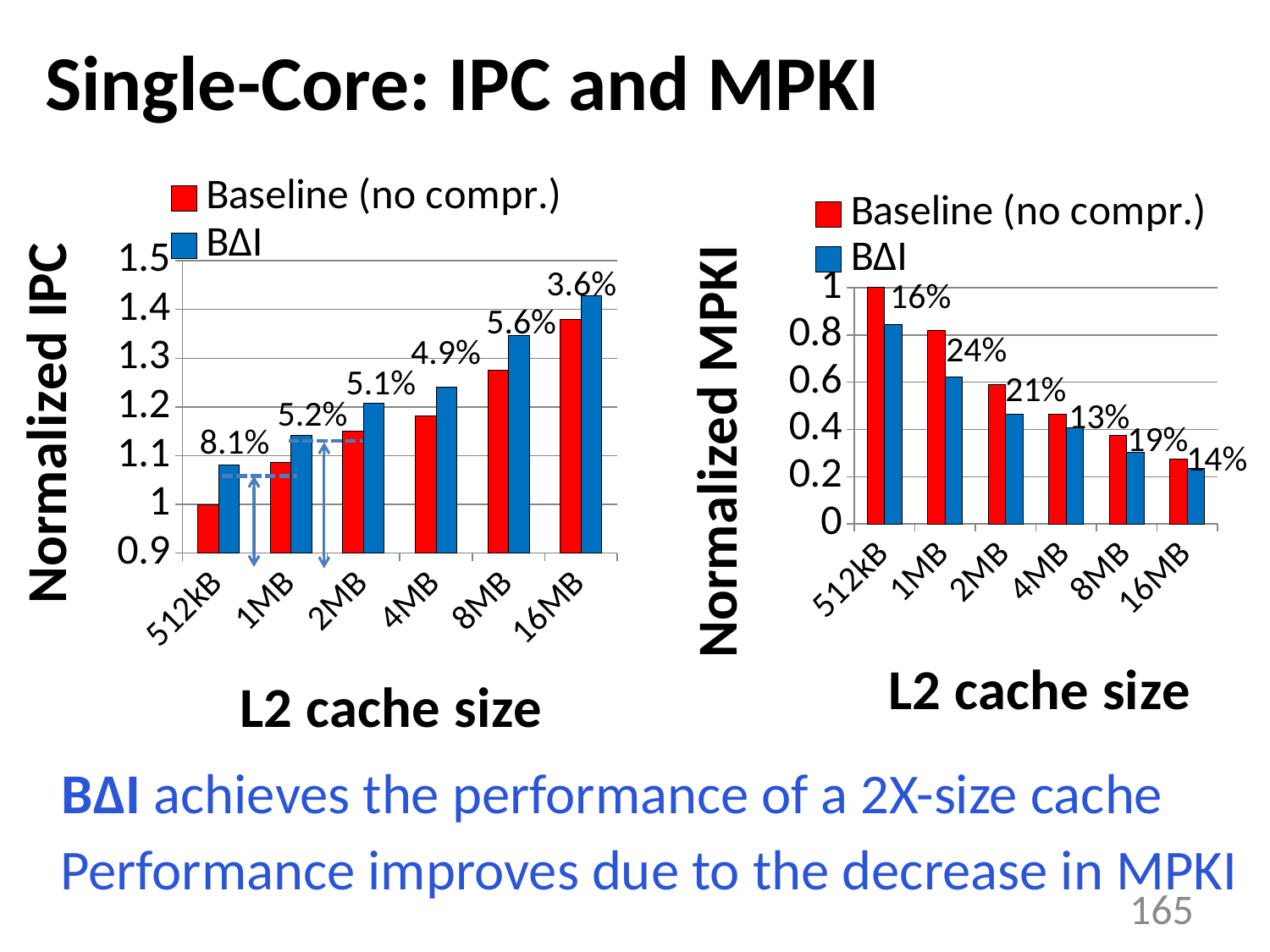
In the Normalized MPKI chart, what is the Baseline (no compr.) value for 512kB? 1 In the Normalized IPC chart, which is larger at 4MB: Baseline (no compr.) or BΔI? BΔI What kind of chart is the Normalized IPC chart on the left? bar chart In the Normalized MPKI chart, which cache size has the largest percentage label? 1MB How many L2 cache sizes are shown on the x axis of the Normalized IPC chart? 6 In the Normalized MPKI chart, which cache size has the smallest percentage label? 4MB In the Normalized IPC chart, what percentage label is shown for the 512kB cache size? 8.1% In the Normalized MPKI chart, is the Baseline (no compr.) value for 2MB greater or less than 0.4? greater In the Normalized MPKI chart, what percentage label is shown for the 1MB cache size? 24% How many series does the legend of the Normalized MPKI chart list? 2 In the Normalized IPC chart, do the Baseline (no compr.) values rise or fall as the L2 cache size increases? rise In the Normalized IPC chart, which cache size has the smallest percentage label? 16MB